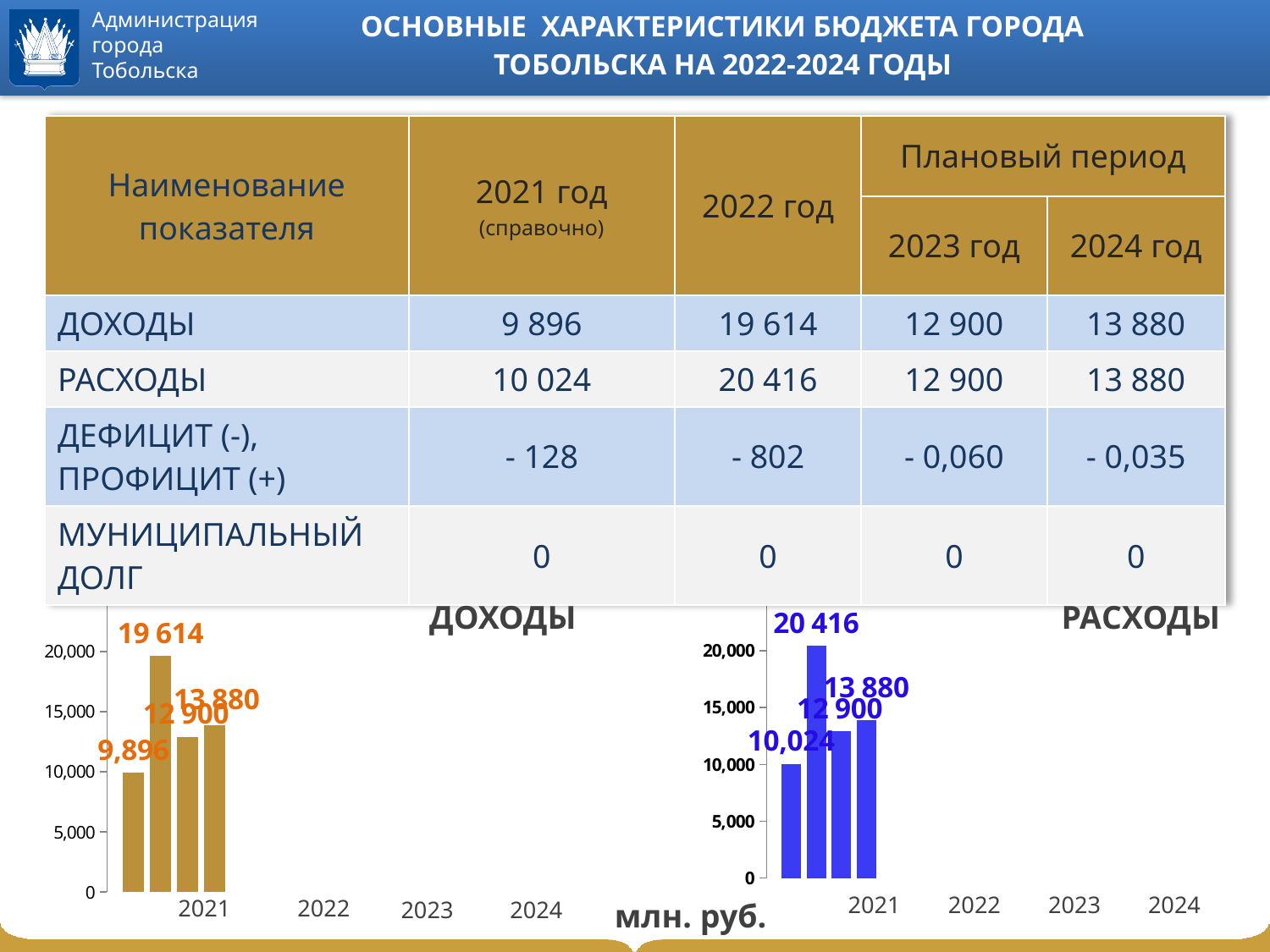
What type of chart is the РАСХОДЫ chart? bar chart In the ДОХОДЫ chart, which bar is the lowest? 2021 In the РАСХОДЫ chart, what is the difference between the 2024 bar (13 880) and the 2023 bar (12 900)? 980 In the ДОХОДЫ chart, what is the value of the tallest bar? 19 614 In the РАСХОДЫ chart, what is the value of the tallest bar? 20 416 In the РАСХОДЫ chart, what is the value of the first (2021) bar? 10,024 In the РАСХОДЫ chart, is the 2021 bar greater or less than 15,000? less In the ДОХОДЫ chart, what is the value of the first (2021) bar? 9,896 In the РАСХОДЫ chart, which bar is the highest? 2022 In the ДОХОДЫ chart, is the 2022 bar greater or less than 15,000? greater In the ДОХОДЫ chart, what is the difference between the 2022 bar (19 614) and the 2021 bar (9,896)? 9 718 How many bars does the ДОХОДЫ chart have? 4